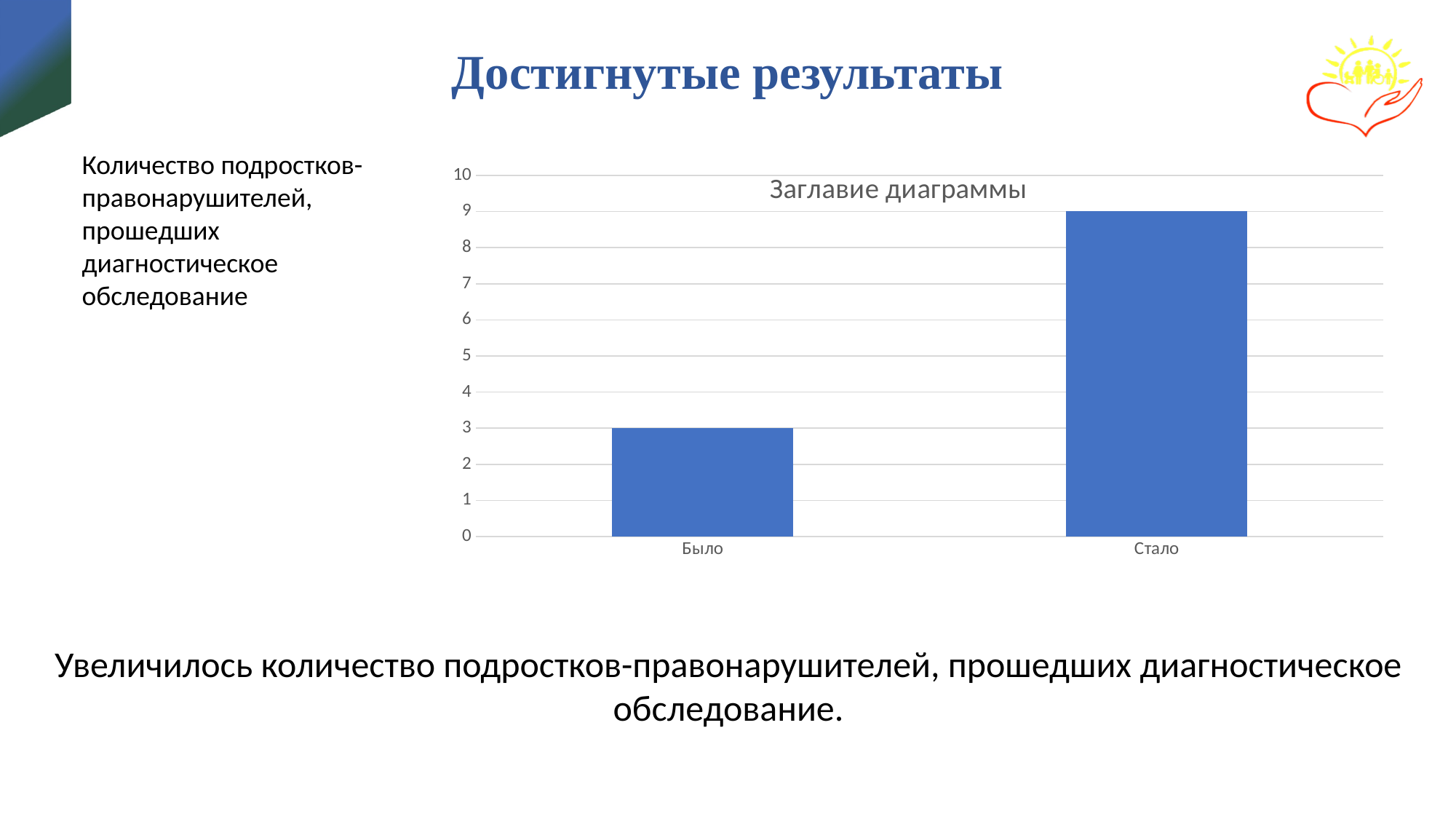
What is the difference between the values for "Стало" and "Было"? 6 Is the value for "Было" greater or less than 5? less Is the value for "Стало" greater or less than 5? greater Do the values rise or fall from "Было" to "Стало"? rise Which category has the lowest value? Было What type of chart is shown on the slide? bar chart Which category has the highest value? Стало What is the title shown on the chart? Заглавие диаграммы What is the value for "Стало"? 9 How many categories are shown on the x axis of the chart? 2 What is the value for "Было"? 3 Which is larger, the value for "Было" or the value for "Стало"? Стало